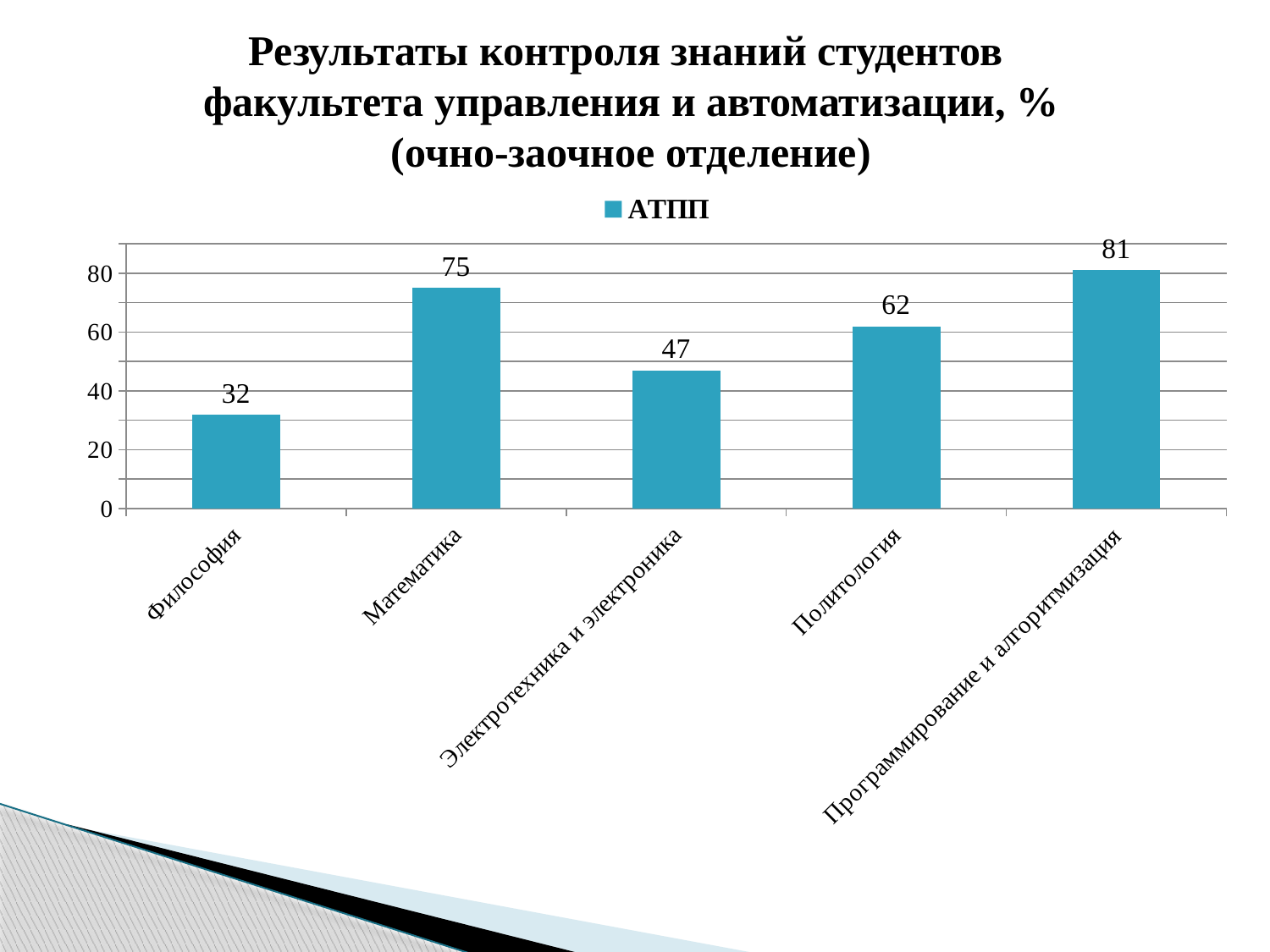
Which category has the highest value? Программирование и алгоритмизация What is the difference between the values for Программирование и алгоритмизация and Философия? 49 What kind of chart is shown on the slide? bar chart What is the value for Электротехника и электроника? 47 What is the value for Математика? 75 What is the value for Философия? 32 What is the value for Политология? 62 How many categories are shown on the x axis? 5 Which category has the lowest value? Философия Which is larger, the value for Математика or the value for Политология? Математика How many series does the legend list? 1 What series name is shown in the legend? АТПП